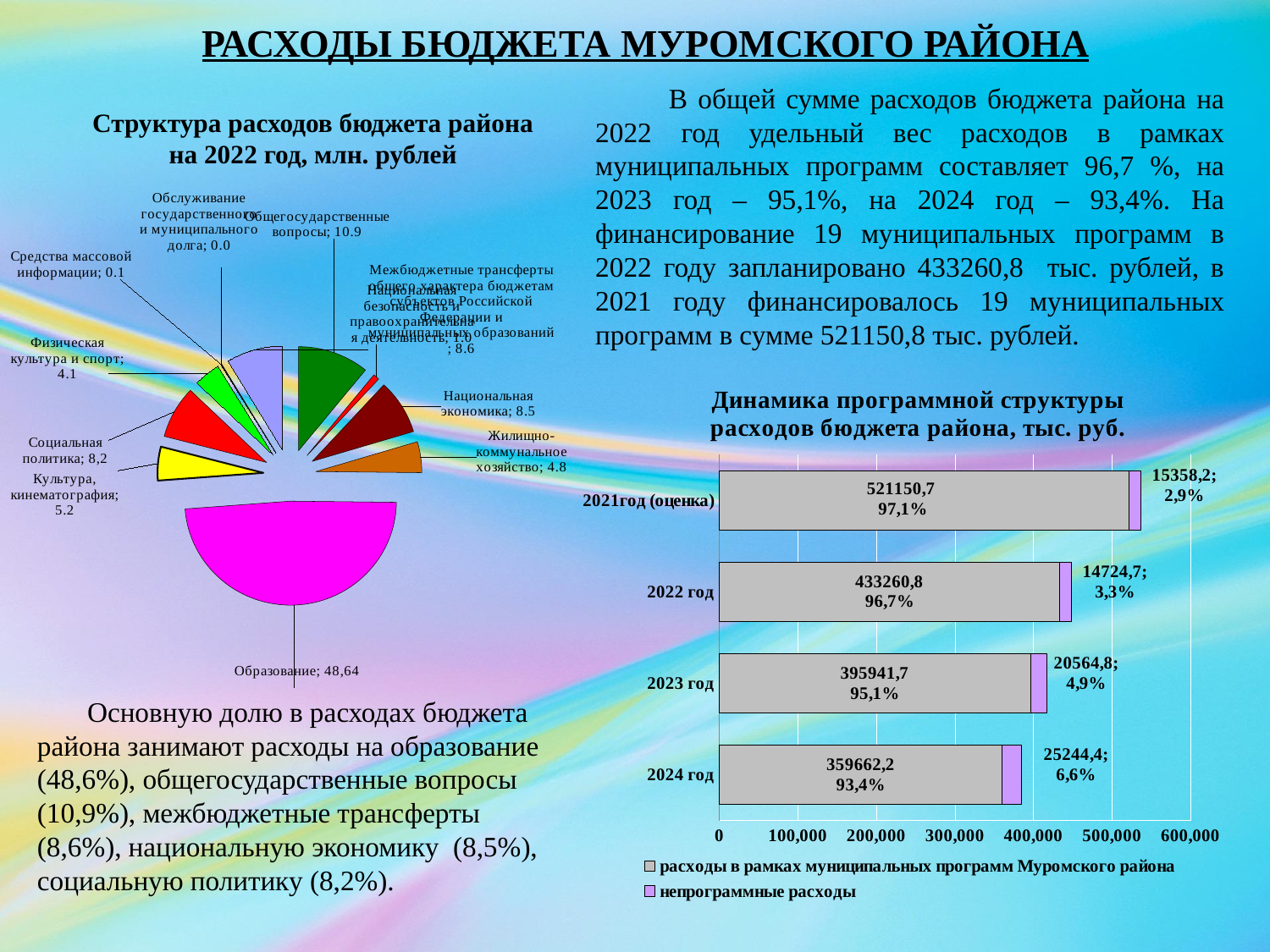
In the chart 'Динамика программной структуры расходов бюджета района, тыс. руб.', what is the difference between расходы в рамках муниципальных программ in 2021год (оценка) and in 2022 год? 87889,9 What kind of chart is 'Динамика программной структуры расходов бюджета района, тыс. руб.'? bar chart In the pie chart 'Структура расходов бюджета района на 2022 год, млн. рублей', which is larger: Социальная политика or Культура, кинематография? Социальная политика In the chart 'Динамика программной структуры расходов бюджета района, тыс. руб.', what is the value of непрограммные расходы for 2024 год? 25244,4 In the chart 'Динамика программной структуры расходов бюджета района, тыс. руб.', what is the total of the stacked bar for 2024 год? 384906,6 In the pie chart 'Структура расходов бюджета района на 2022 год, млн. рублей', which category is the largest? Образование In the chart 'Динамика программной структуры расходов бюджета района, тыс. руб.', what share do непрограммные расходы make up in 2023 год? 4,9% In the chart 'Динамика программной структуры расходов бюджета района, тыс. руб.', how many series does the legend list? 2 In the pie chart 'Структура расходов бюджета района на 2022 год, млн. рублей', what is the value for Национальная экономика? 8.5 In the chart 'Динамика программной структуры расходов бюджета района, тыс. руб.', do расходы в рамках муниципальных программ rise or fall from 2021 to 2024? fall In the chart 'Динамика программной структуры расходов бюджета района, тыс. руб.', what is the value of расходы в рамках муниципальных программ for 2022 год? 433260,8 In the chart 'Динамика программной структуры расходов бюджета района, тыс. руб.', which year has the highest value of расходы в рамках муниципальных программ? 2021год (оценка)